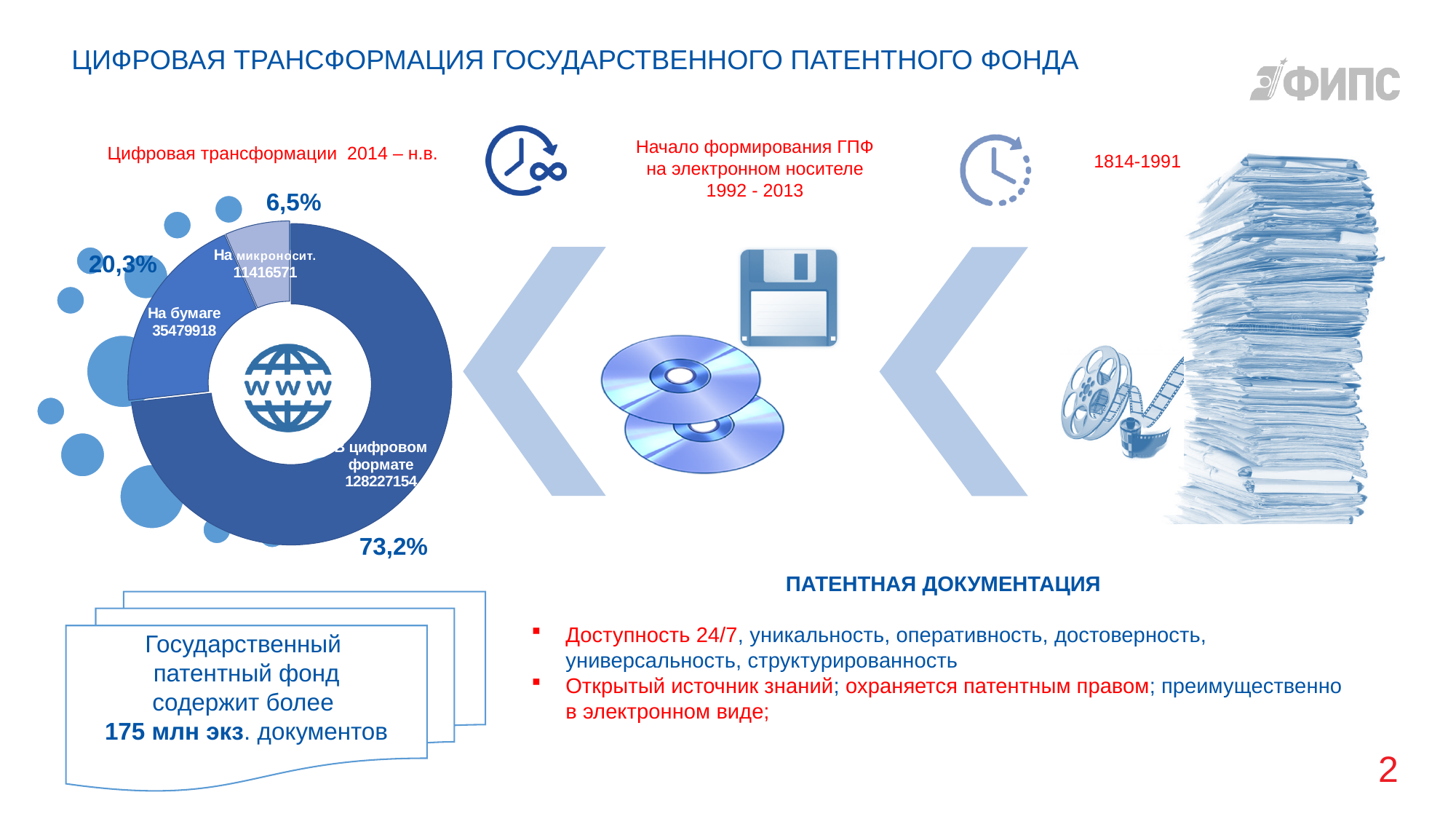
What kind of chart is shown on the slide? doughnut (pie) chart Which segment of the doughnut chart is the smallest? На микроносит. What is the value for the segment "На микроносит."? 11416571 How many segments does the doughnut chart have? 3 What is the value for the segment "На бумаге"? 35479918 Which segment of the doughnut chart is the largest? В цифровом формате What percentage share is shown for the segment "На бумаге"? 20,3% Which is larger: the value for "На бумаге" or the value for "На микроносит."? На бумаге What percentage share is shown for the segment "В цифровом формате"? 73,2% What is the value for the segment "В цифровом формате"? 128227154 What is the difference between the values for "В цифровом формате" and "На бумаге"? 92747236 What percentage share is shown for the segment "На микроносит."? 6,5%